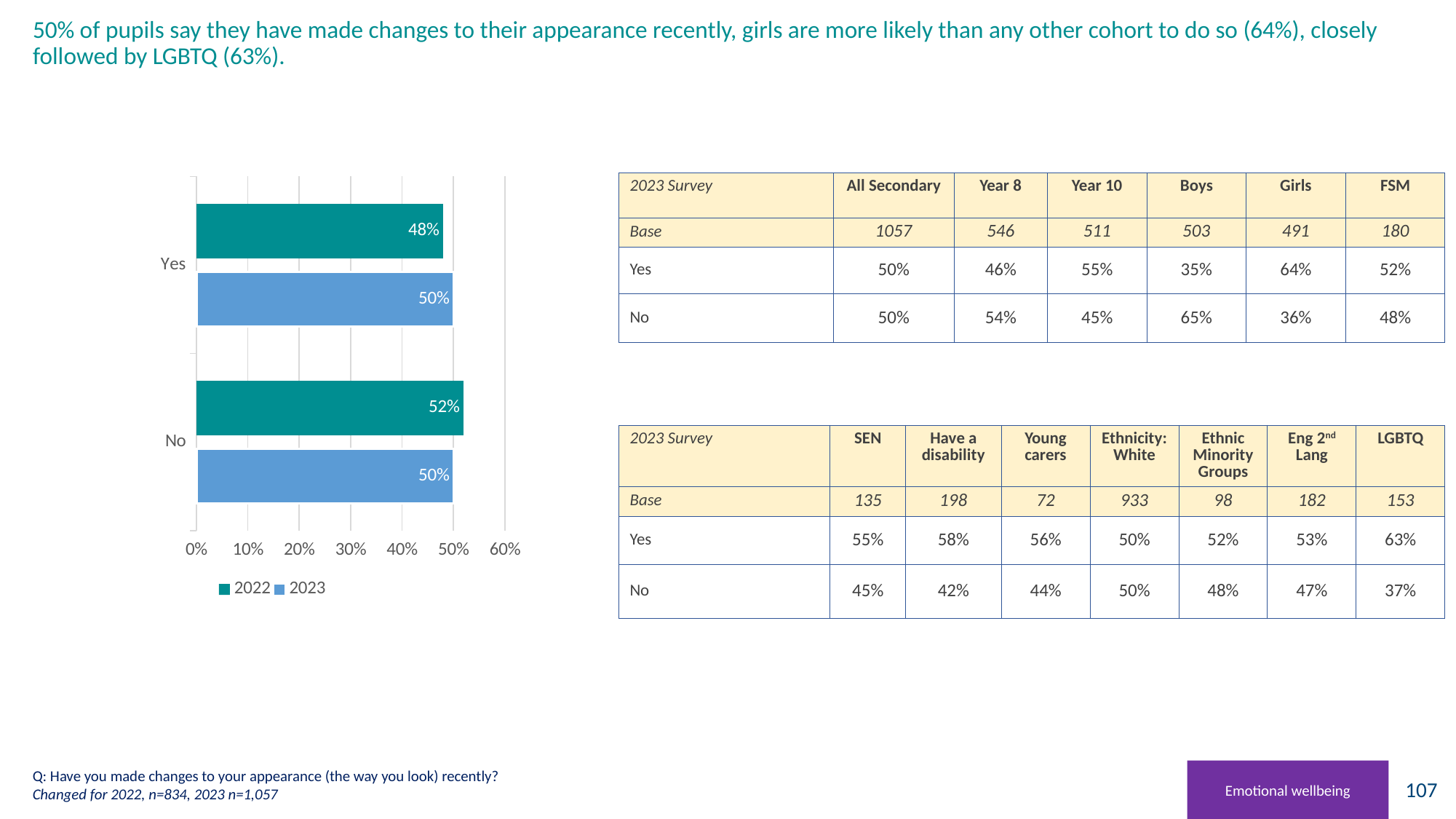
What is the 2022 value for No? 52% How many series does the legend list? 2 Which category has the highest 2022 value? No What kind of chart is shown on the slide? Bar chart Which category has the lowest 2022 value? Yes What is the 2023 value for Yes? 50% What is the difference between the 2022 values for No and Yes? 4% What is the 2023 value for No? 50% Which is larger for Yes: the 2022 value or the 2023 value? 2023 What is the 2022 value for Yes? 48% Is the 2022 value for No greater or less than 50%? greater How many categories are shown on the chart? 2